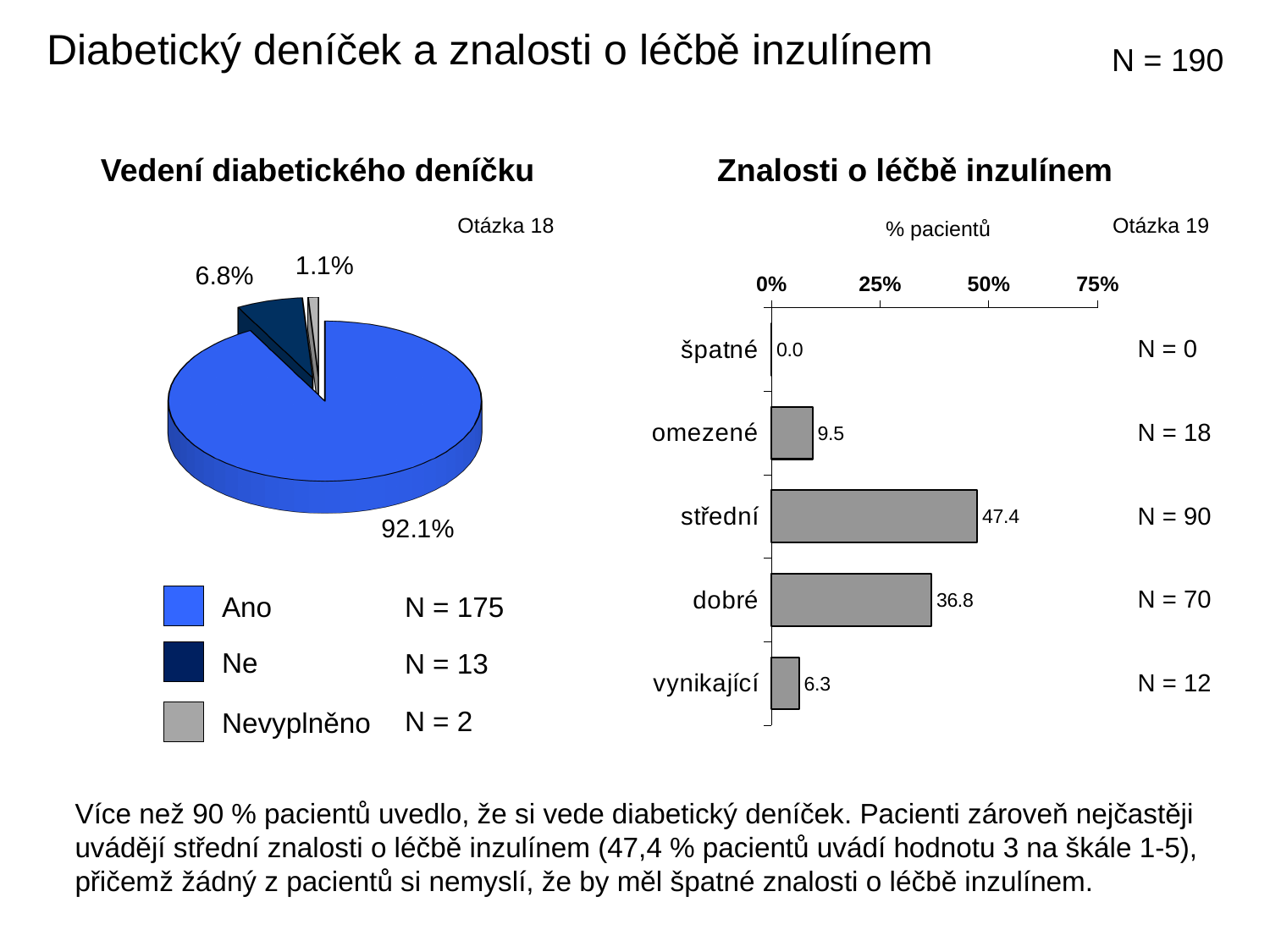
In the 'Vedení diabetického deníčku' pie chart, what is the N value shown for Ne? N = 13 In the 'Vedení diabetického deníčku' pie chart, what percentage is shown for Ano? 92.1% In the 'Znalosti o léčbě inzulínem' chart, which category has the highest value? střední In the 'Znalosti o léčbě inzulínem' chart, what is the value for střední? 47.4 In the 'Vedení diabetického deníčku' pie chart, what percentage is shown for Ne? 6.8% In the 'Znalosti o léčbě inzulínem' chart, which is larger, the value for omezené or the value for vynikající? omezené In the 'Znalosti o léčbě inzulínem' chart, which category has the lowest value? špatné In the 'Znalosti o léčbě inzulínem' chart, what is the value for vynikající? 6.3 In the 'Znalosti o léčbě inzulínem' chart, what is the difference between the values for střední and dobré? 10.6 In the 'Vedení diabetického deníčku' pie chart, how many categories does the legend list? 3 In the 'Vedení diabetického deníčku' pie chart, which category has the smallest slice? Nevyplněno What kind of chart is 'Znalosti o léčbě inzulínem'? bar chart